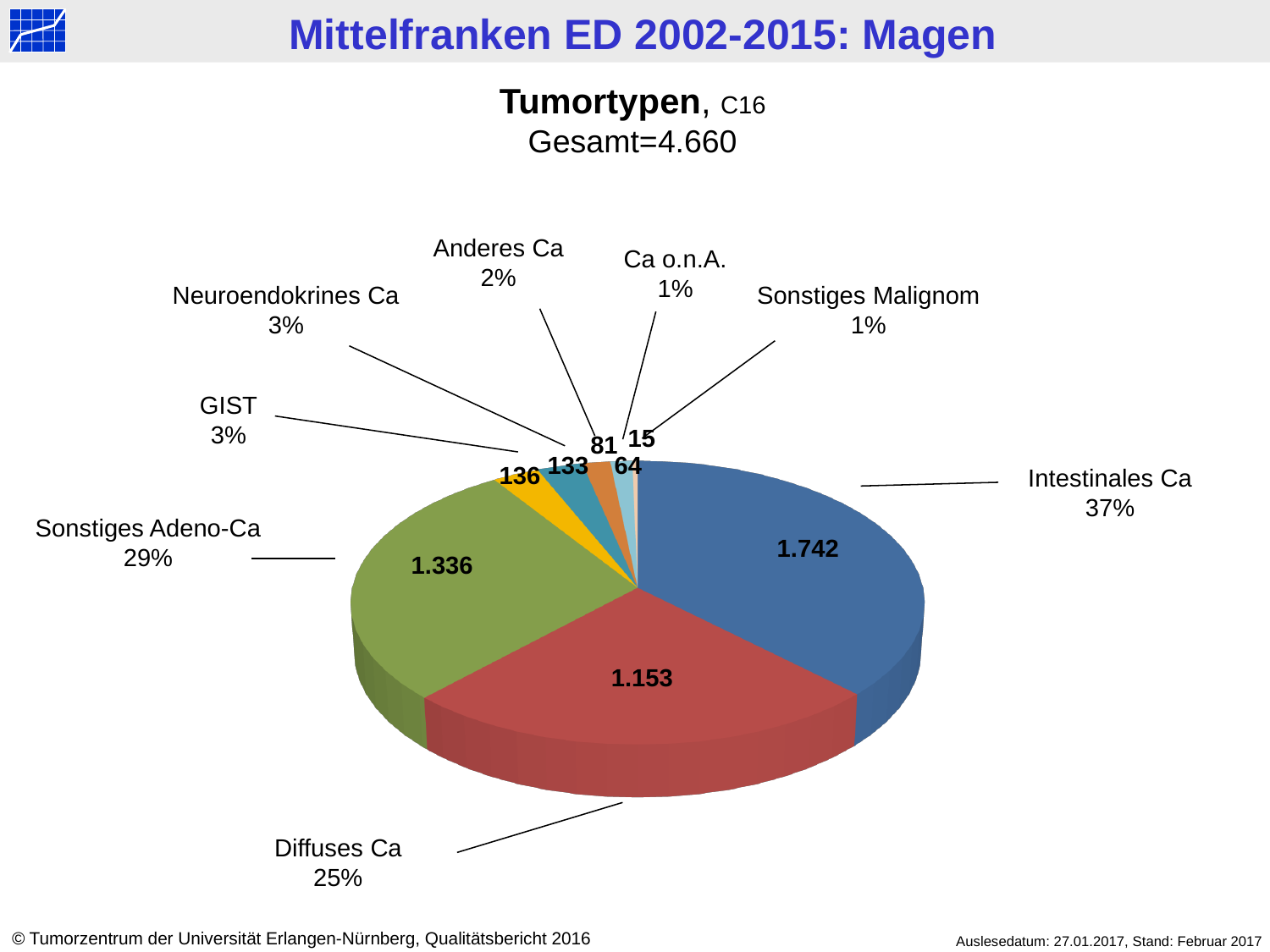
What share of the pie does GIST represent? 3% What share of the pie does Sonstiges Adeno-Ca represent? 29% What kind of chart is shown on the slide? pie chart What is the value shown for Intestinales Ca? 1.742 What is the value shown for Sonstiges Adeno-Ca? 1.336 What is the value shown for Diffuses Ca? 1.153 What total (Gesamt) is stated above the pie chart? 4.660 How many tumour type categories does the pie chart show? 8 What share of the pie does Intestinales Ca represent? 37% What is the difference between the values for Intestinales Ca and Diffuses Ca? 589 Which tumour type has the largest slice of the pie? Intestinales Ca Which is larger, Sonstiges Adeno-Ca or Diffuses Ca? Sonstiges Adeno-Ca